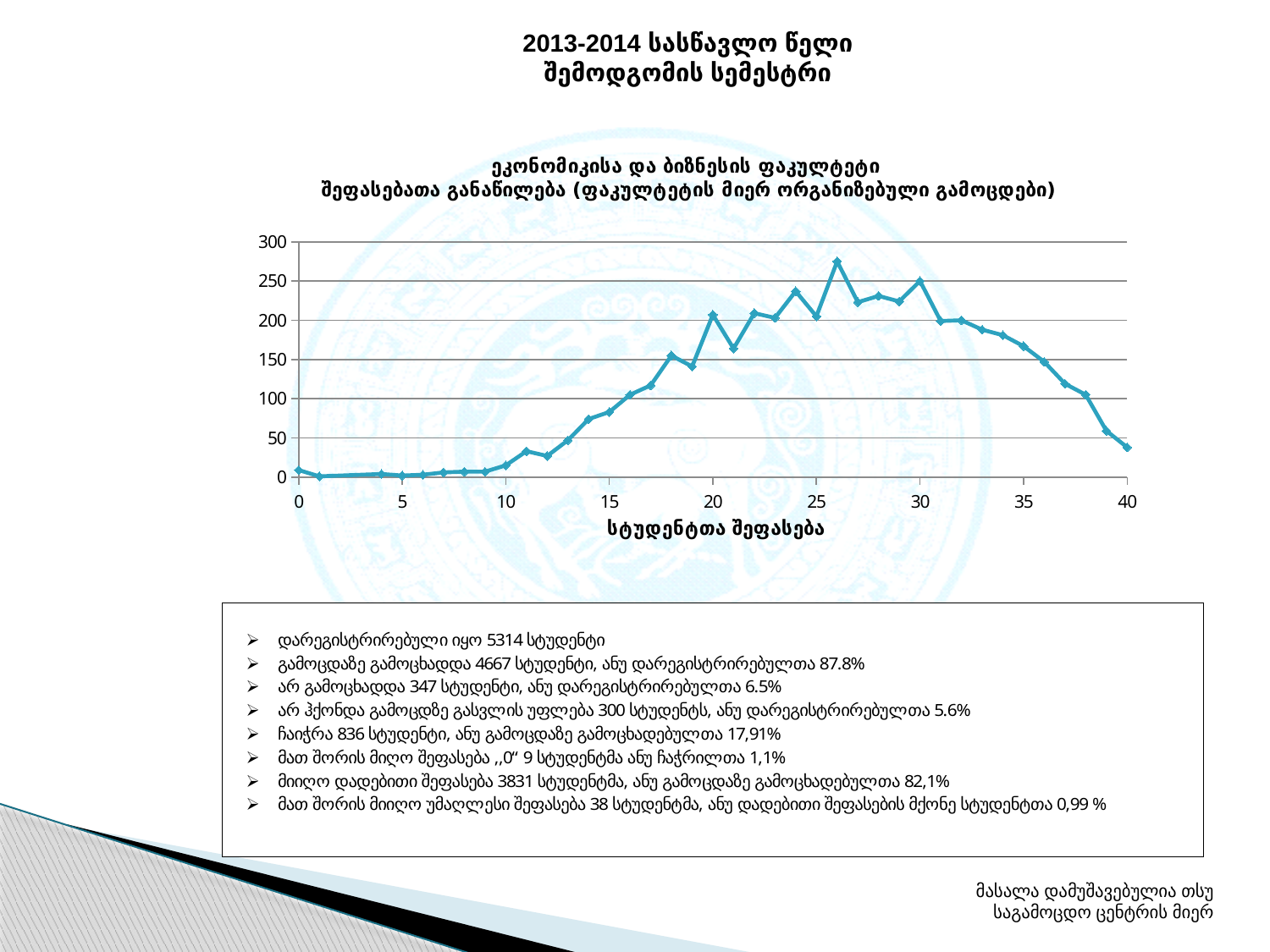
Is the value at score 15 greater or less than 100? less Does the line generally rise or fall between scores 10 and 26? rise Is the value at score 26 greater or less than 250? greater Is the value at score 40 greater or less than 50? less Does the line generally rise or fall between scores 30 and 40? fall What is the label of the x axis? სტუდენტთა შეფასება What kind of chart is shown on the slide? line chart At which score on the x axis does the line reach its highest value? 26 Which has the higher value: score 26 or score 30? 26 Which has the higher value: score 10 or score 20? 20